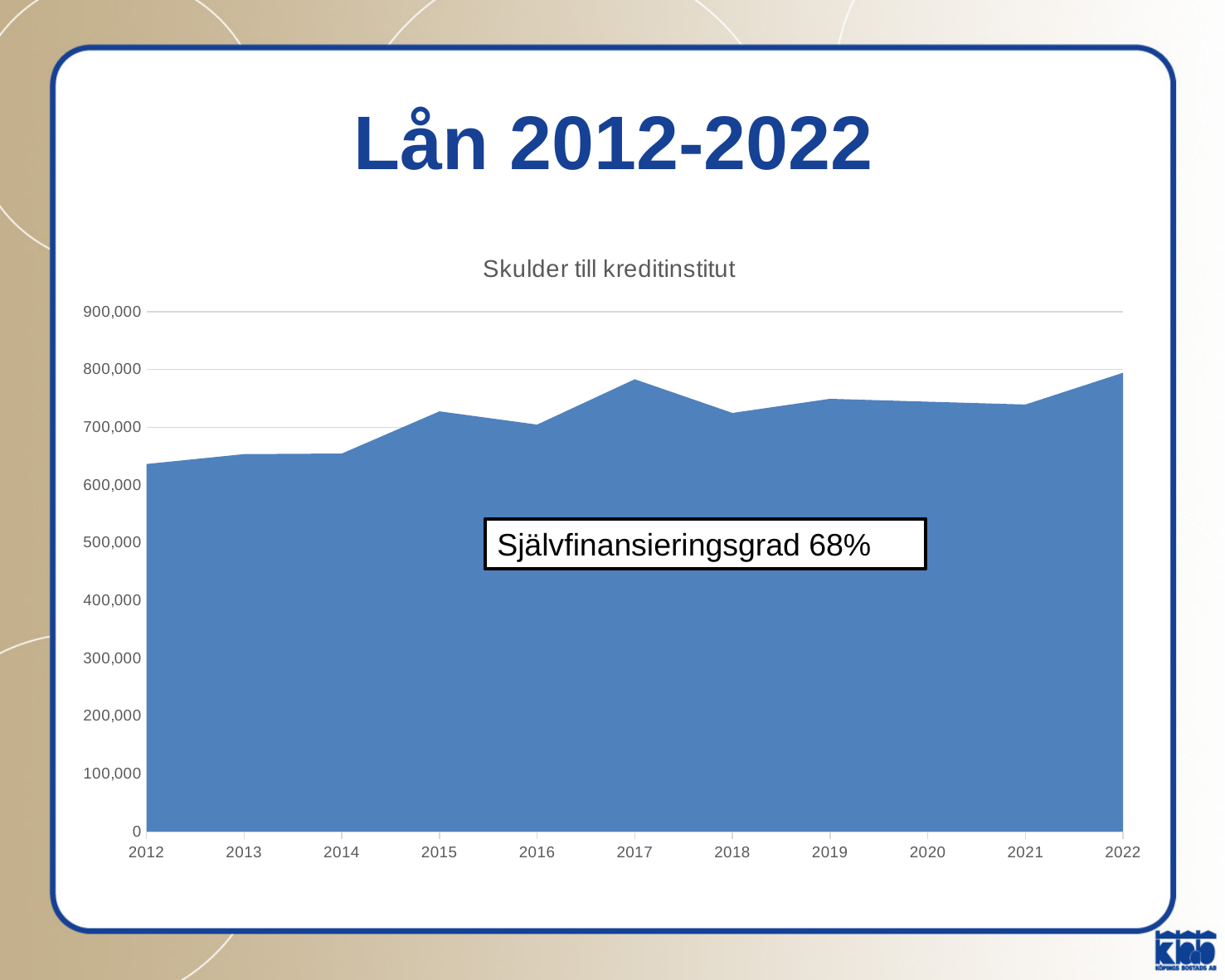
Is the value for 2014 greater or less than 600,000? greater What kind of chart is shown on the slide? area chart Which year has the larger value, 2012 or 2015? 2015 Do the values generally rise or fall from 2012 to 2022? rise Which year has the larger value, 2017 or 2018? 2017 What is the title of the chart? Skulder till kreditinstitut How many years are plotted along the x axis of the chart? 11 Is the value for 2012 greater or less than 700,000? less Is the value for 2017 greater or less than 700,000? greater Which year has the lowest value in the chart? 2012 What percentage is stated in the text box overlaid on the chart? 68%